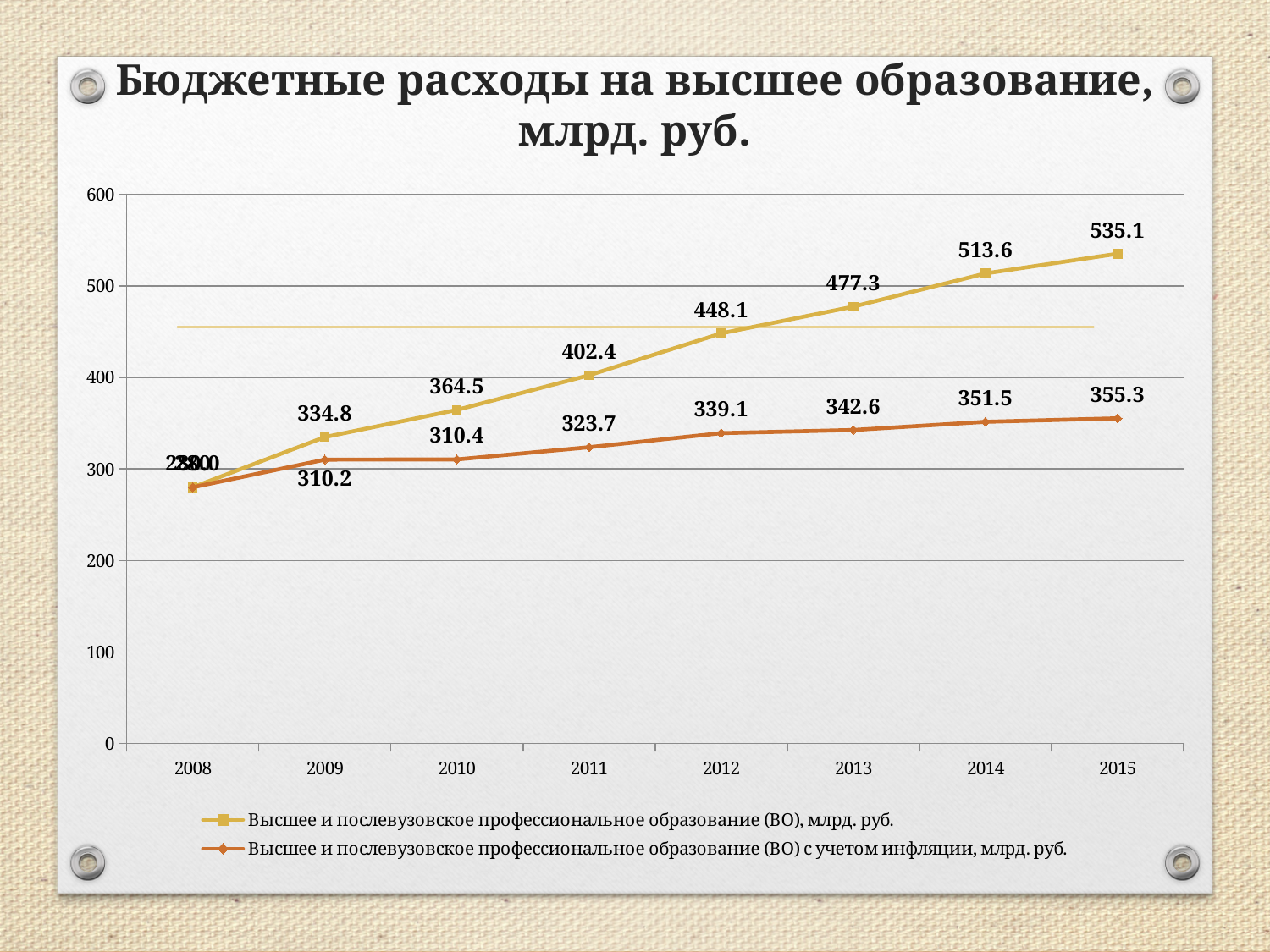
How many years are plotted along the x axis? 8 Do the values of the series 'Высшее и послевузовское профессиональное образование (ВО), млрд. руб.' rise or fall from 2008 to 2015? rise In which year is the series 'Высшее и послевузовское профессиональное образование (ВО), млрд. руб.' highest? 2015 What type of chart is shown on the slide? line chart What is the value of the series 'Высшее и послевузовское профессиональное образование (ВО), млрд. руб.' in 2010? 364.5 In which year is the inflation-adjusted series ('с учетом инфляции') lowest? 2008 What is the value of the inflation-adjusted series ('с учетом инфляции') in 2014? 351.5 What is the value of the series 'Высшее и послевузовское профессиональное образование (ВО), млрд. руб.' in 2012? 448.1 What is the difference between the two series in 2015 (535.1 and 355.3)? 179.8 Is the value for 2008 greater or less than 300? less How many series does the legend list? 2 Which series has the larger value in 2013: the nominal series or the inflation-adjusted series? Высшее и послевузовское профессиональное образование (ВО), млрд. руб.